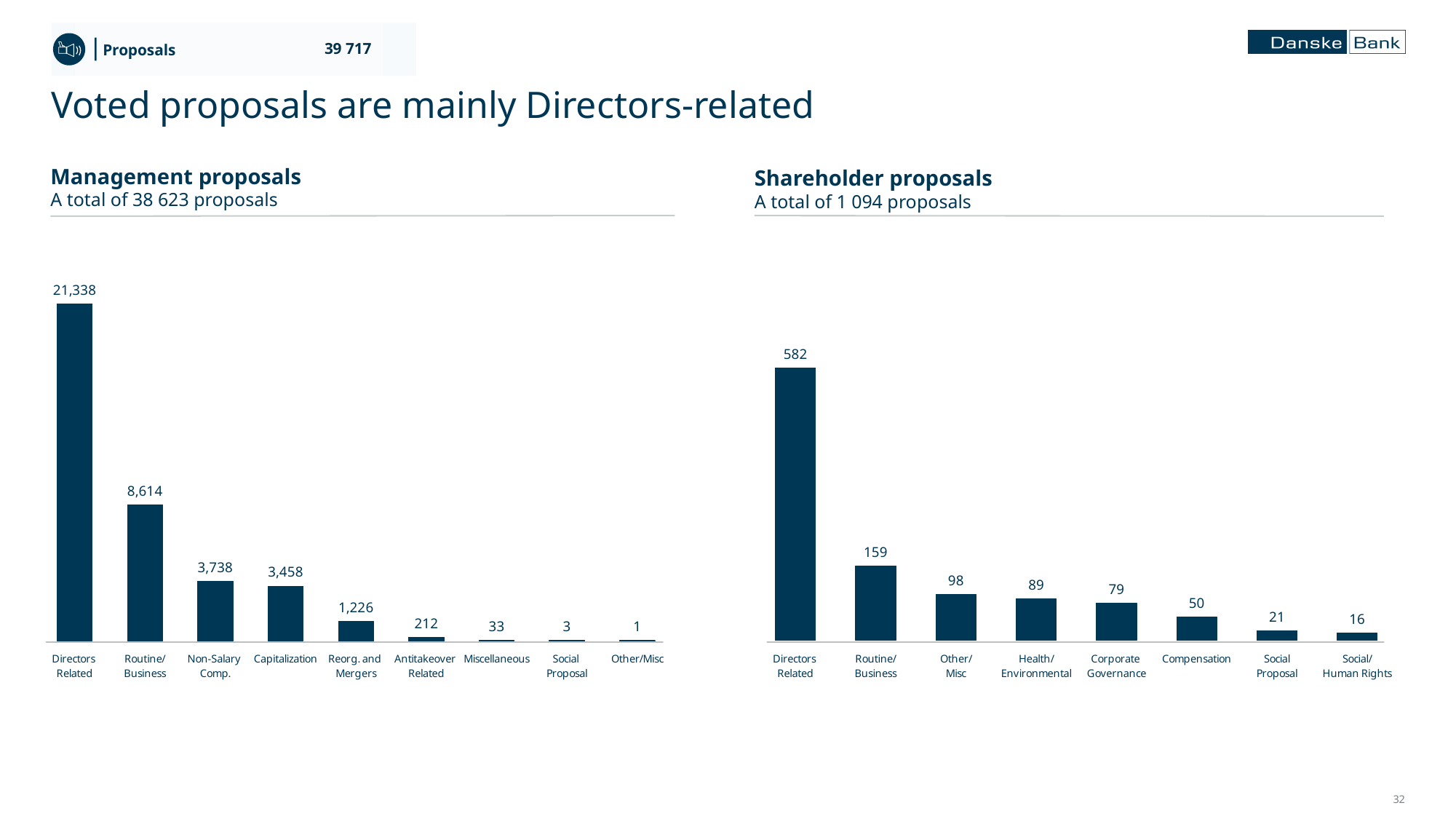
In the Shareholder proposals chart, which category has the highest value? Directors Related In the Management proposals chart, what is the value for Reorg. and Mergers? 1,226 What kind of chart is the Shareholder proposals chart? Bar chart In the Shareholder proposals chart, what is the value for Compensation? 50 In the Management proposals chart, which category has the lowest value? Other/Misc How many categories are shown in the Management proposals chart? 9 In the Shareholder proposals chart, which is larger, Other/Misc or Corporate Governance? Other/Misc In the Shareholder proposals chart, what is the value for Health/Environmental? 89 In the Shareholder proposals chart, what is the difference between Directors Related and Routine/Business? 423 How many categories are shown in the Shareholder proposals chart? 8 In the Management proposals chart, what is the difference between Non-Salary Comp. and Capitalization? 280 In the Management proposals chart, what is the value for Directors Related? 21,338